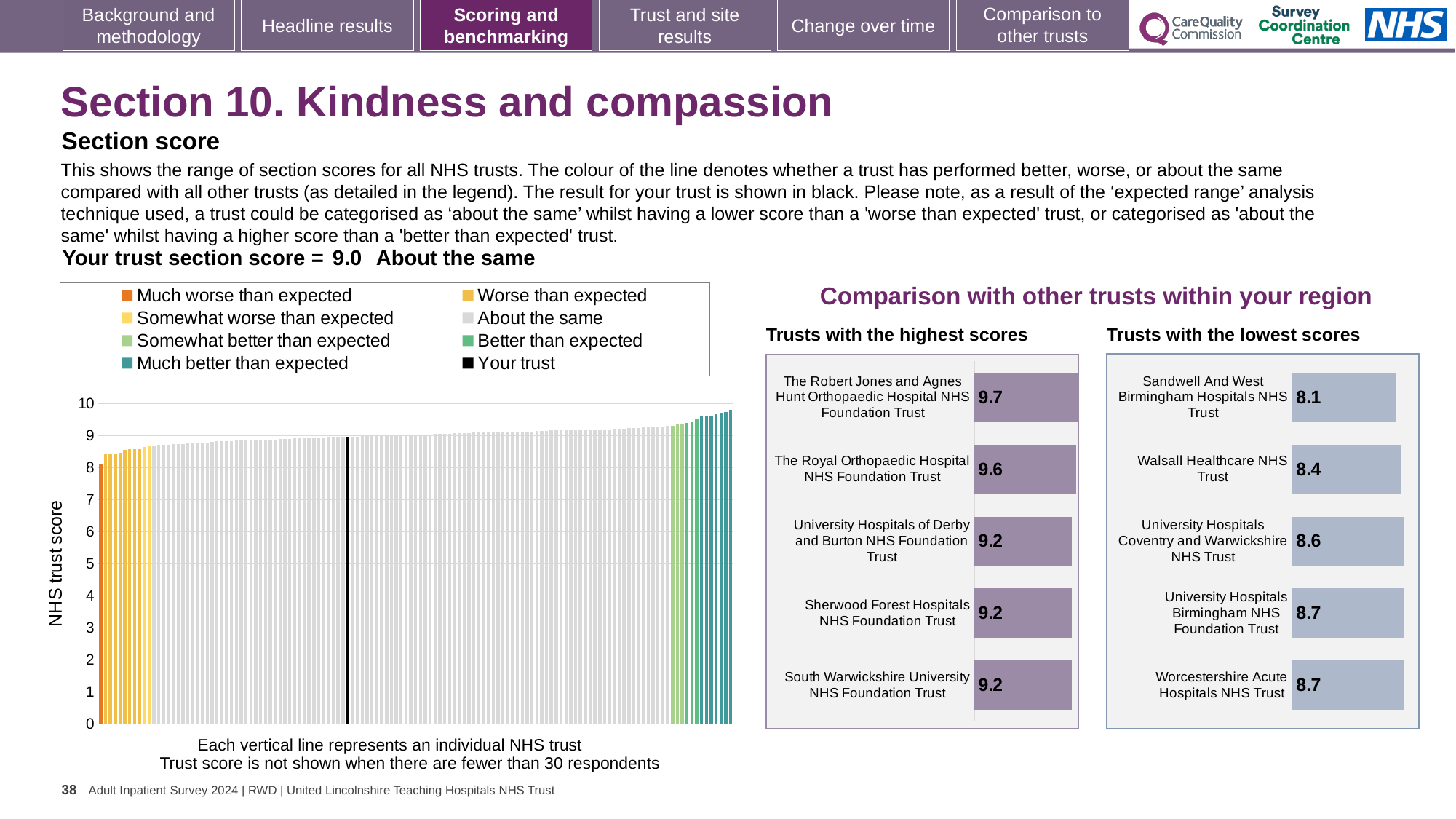
In the 'Trusts with the highest scores' chart, which trust has the highest score? The Robert Jones and Agnes Hunt Orthopaedic Hospital NHS Foundation Trust In the main NHS trust score chart on the left, do the bar values rise or fall from left to right? rise In the 'Trusts with the lowest scores' chart, what is the score for Walsall Healthcare NHS Trust? 8.4 In the 'Trusts with the lowest scores' chart, which has the larger score: Walsall Healthcare NHS Trust or University Hospitals Coventry and Warwickshire NHS Trust? University Hospitals Coventry and Warwickshire NHS Trust In the 'Trusts with the highest scores' chart, what is the score for The Royal Orthopaedic Hospital NHS Foundation Trust? 9.6 How many entries does the legend of the main NHS trust score chart on the left list? 8 How many trusts are listed in the 'Trusts with the highest scores' chart? 5 In the 'Trusts with the lowest scores' chart, what is the difference between the scores of Worcestershire Acute Hospitals NHS Trust and Sandwell And West Birmingham Hospitals NHS Trust? 0.6 In the main NHS trust score chart on the left, is the value of the leftmost bar greater or less than 9? less In the 'Trusts with the highest scores' chart, what is the score for The Robert Jones and Agnes Hunt Orthopaedic Hospital NHS Foundation Trust? 9.7 In the 'Trusts with the lowest scores' chart, which trust has the lowest score? Sandwell And West Birmingham Hospitals NHS Trust In the 'Trusts with the lowest scores' chart, what is the score for Sandwell And West Birmingham Hospitals NHS Trust? 8.1